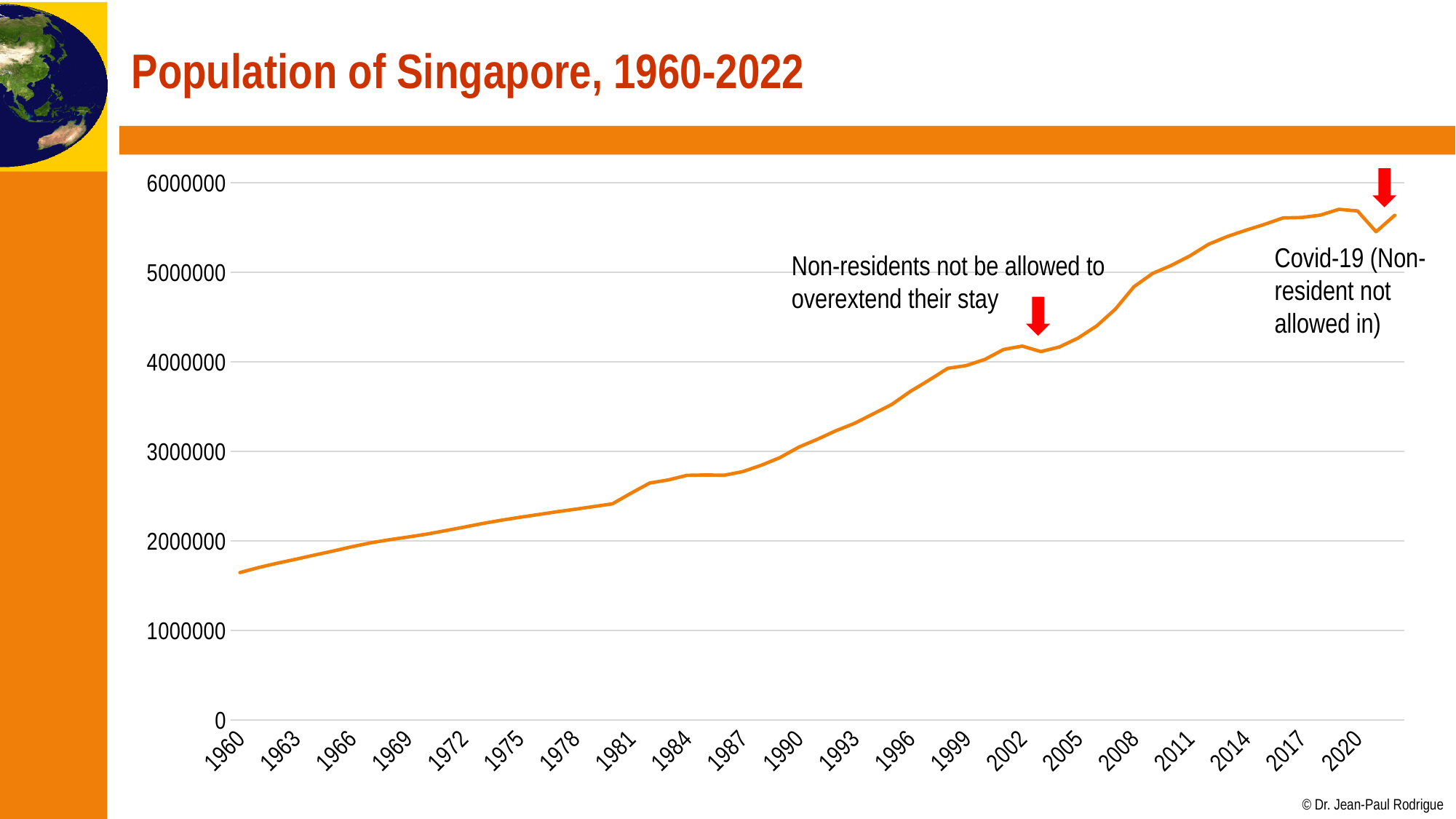
Is the population value for 2014 greater or less than 5000000? greater Overall, does the population rise or fall from 1960 to 2022? rise What kind of chart is shown on the slide? line chart Is the population value for 2020 greater or less than 6000000? less Is the population value for 1960 greater or less than 2000000? less What is the title of the slide's chart? Population of Singapore, 1960-2022 How many year labels are shown on the x axis? 21 Which year on the x axis has the lowest population value? 1960 What event does the annotation near the end of the line attribute the dip in population to? Covid-19 (Non-resident not allowed in)